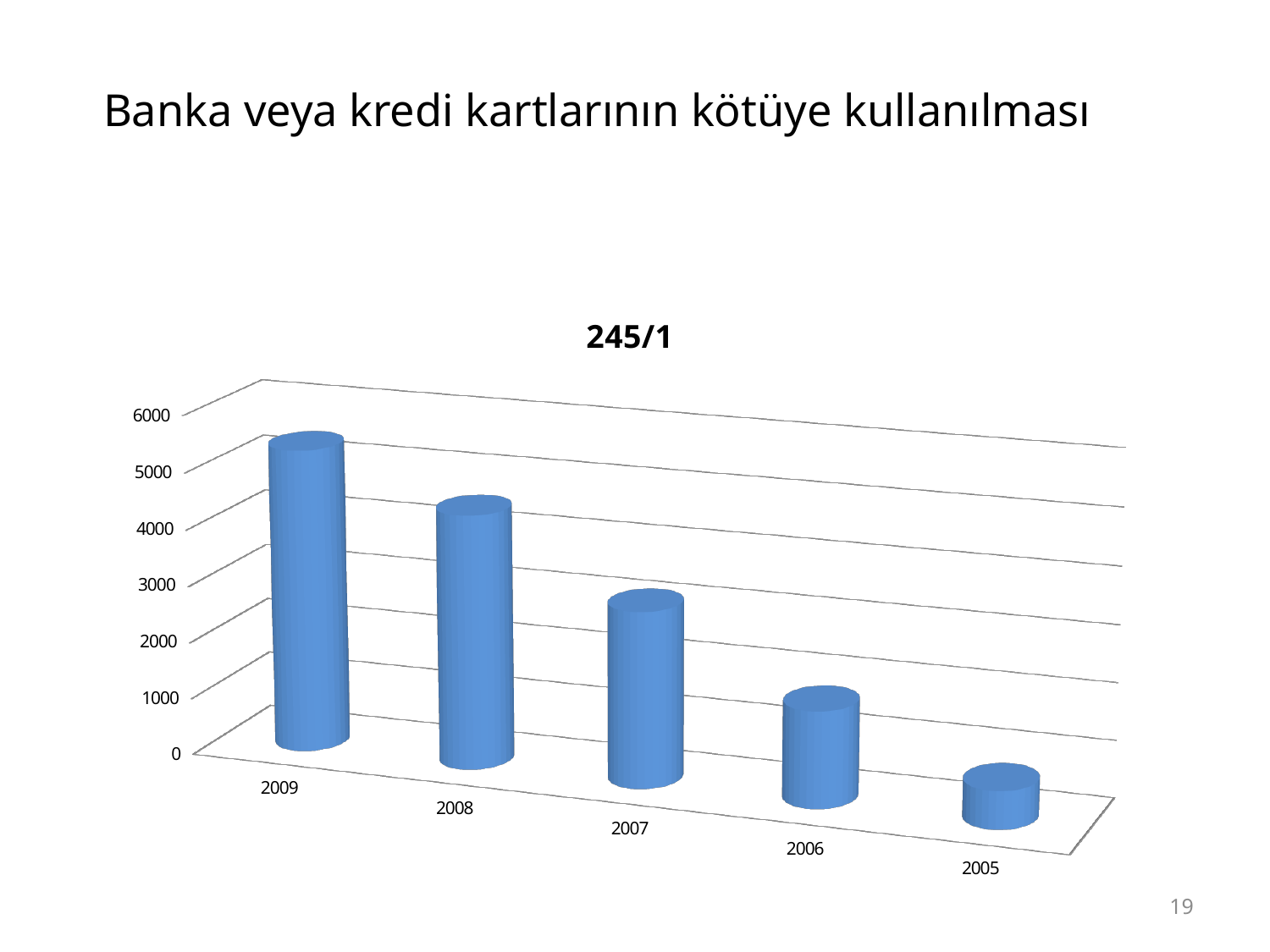
Which is larger, the value for 2006 or the value for 2005? 2006 Which year has the highest value in the chart? 2009 Which is larger, the value for 2008 or the value for 2007? 2008 Is the value for 2005 greater or less than 1000? less What is the title of the chart? 245/1 What kind of chart is shown on the slide? bar chart How many years are shown on the x axis of the chart? 5 Is the value for 2006 greater or less than 2000? less Do the values rise or fall moving from left to right along the x axis (2009 to 2005)? fall Is the value for 2009 greater or less than 4000? greater Which year has the lowest value in the chart? 2005